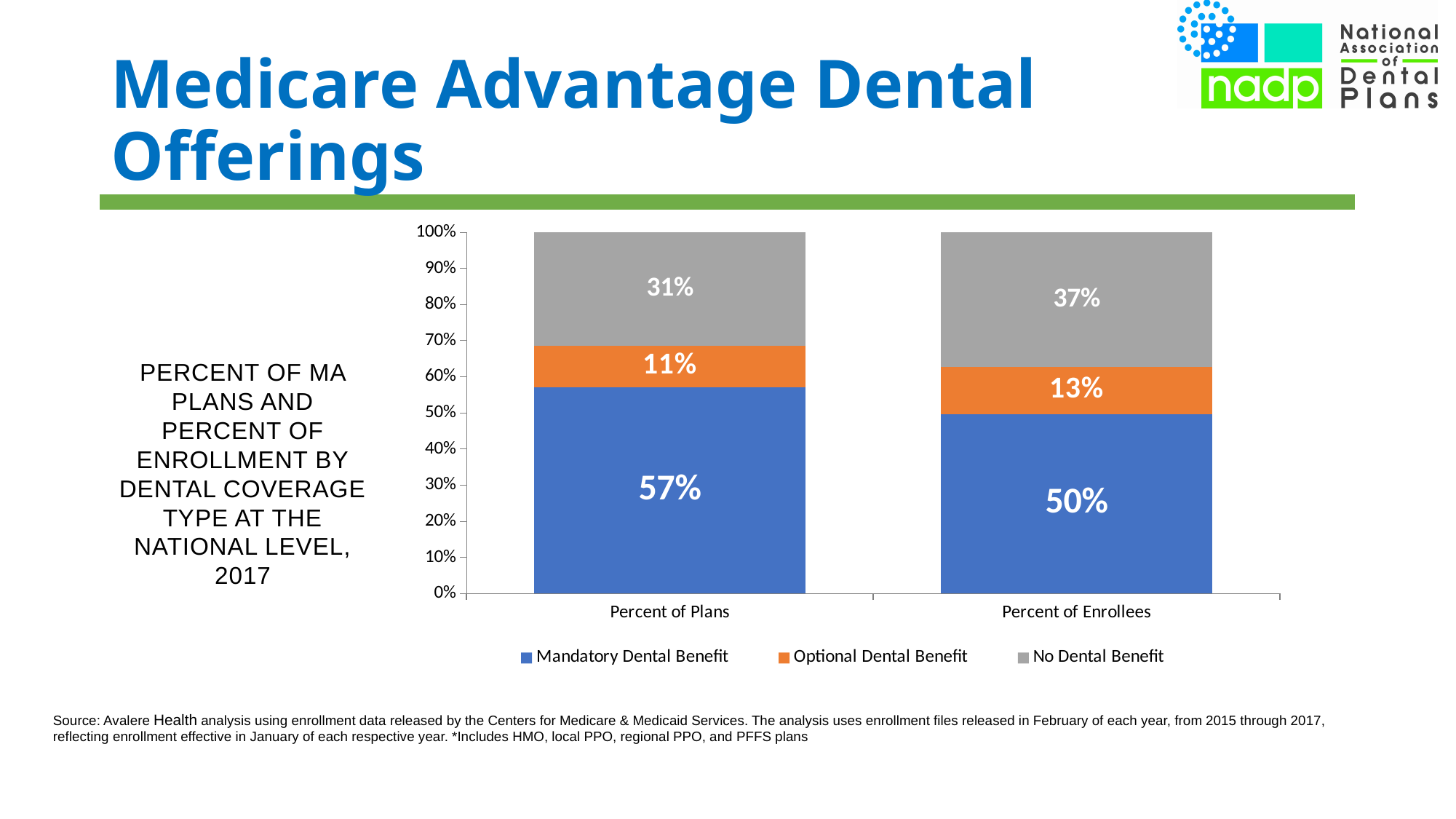
Which series has the smallest value in the Percent of Plans bar? Optional Dental Benefit What is the No Dental Benefit value for Percent of Plans? 31% What is the difference between the Mandatory Dental Benefit values for Percent of Plans and Percent of Enrollees? 7% What is the Optional Dental Benefit value for Percent of Enrollees? 13% What percentage of plans have a Mandatory Dental Benefit? 57% Which series has the largest value in the Percent of Enrollees bar? Mandatory Dental Benefit How many categories are shown on the x axis? 2 What percentage of enrollees have No Dental Benefit? 37% What kind of chart is shown on the slide? Stacked bar chart What is the difference between the No Dental Benefit values for Percent of Enrollees and Percent of Plans? 6% Which category has the higher Mandatory Dental Benefit value, Percent of Plans or Percent of Enrollees? Percent of Plans How many series does the legend list? 3